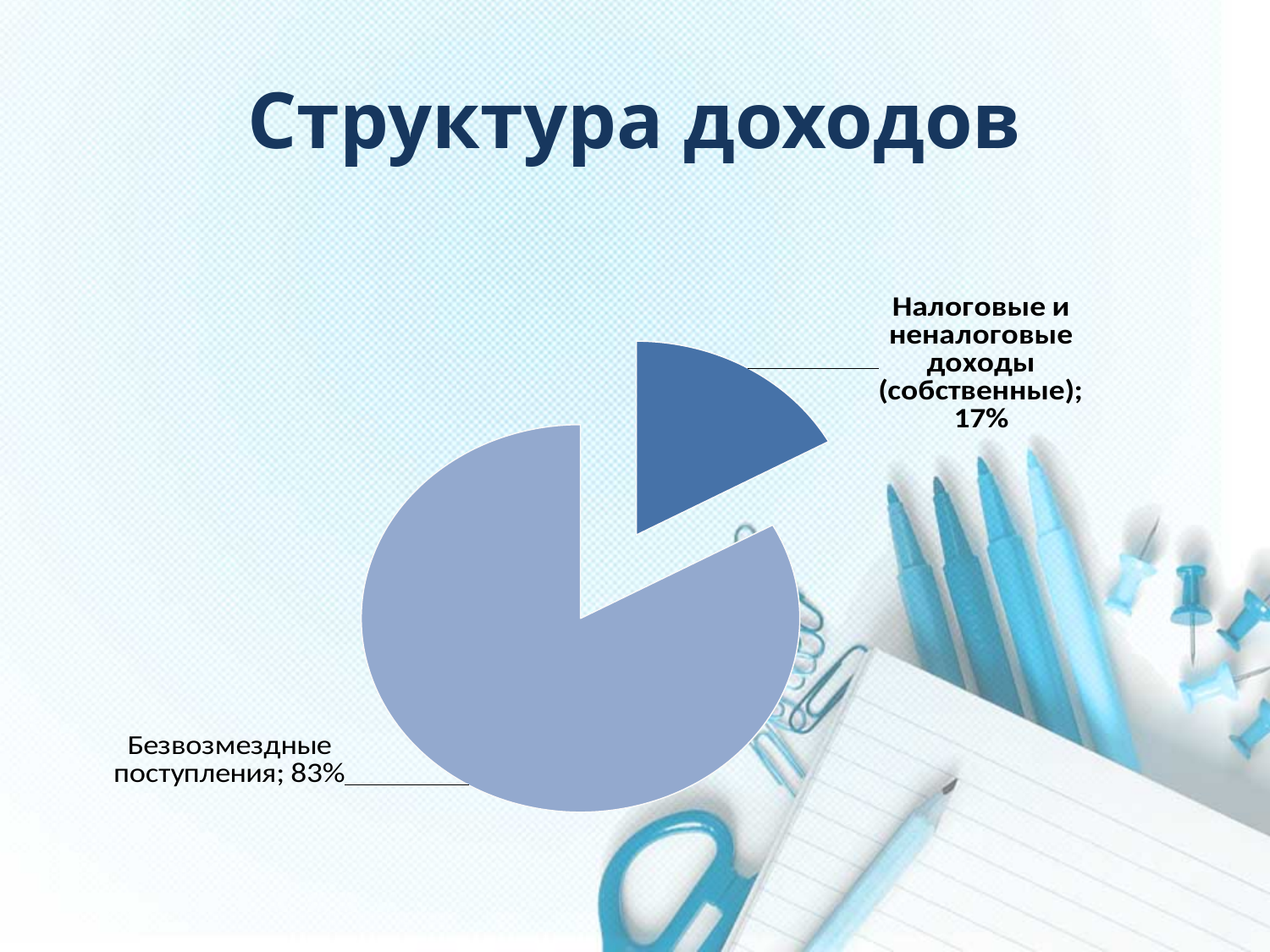
What share of the pie does "Безвозмездные поступления" have? 83% What is the total of the two slice percentages shown on the pie chart? 100% Which category has the largest slice of the pie? Безвозмездные поступления What is the difference in percentage points between "Безвозмездные поступления" and "Налоговые и неналоговые доходы (собственные)"? 66 What is the title of the slide containing the pie chart? Структура доходов Which category has the smallest slice of the pie? Налоговые и неналоговые доходы (собственные) How many slices does the pie chart have? 2 What share of the pie does "Налоговые и неналоговые доходы (собственные)" have? 17% What kind of chart is shown on the slide? pie chart Which is larger: the share of "Безвозмездные поступления" or the share of "Налоговые и неналоговые доходы (собственные)"? Безвозмездные поступления